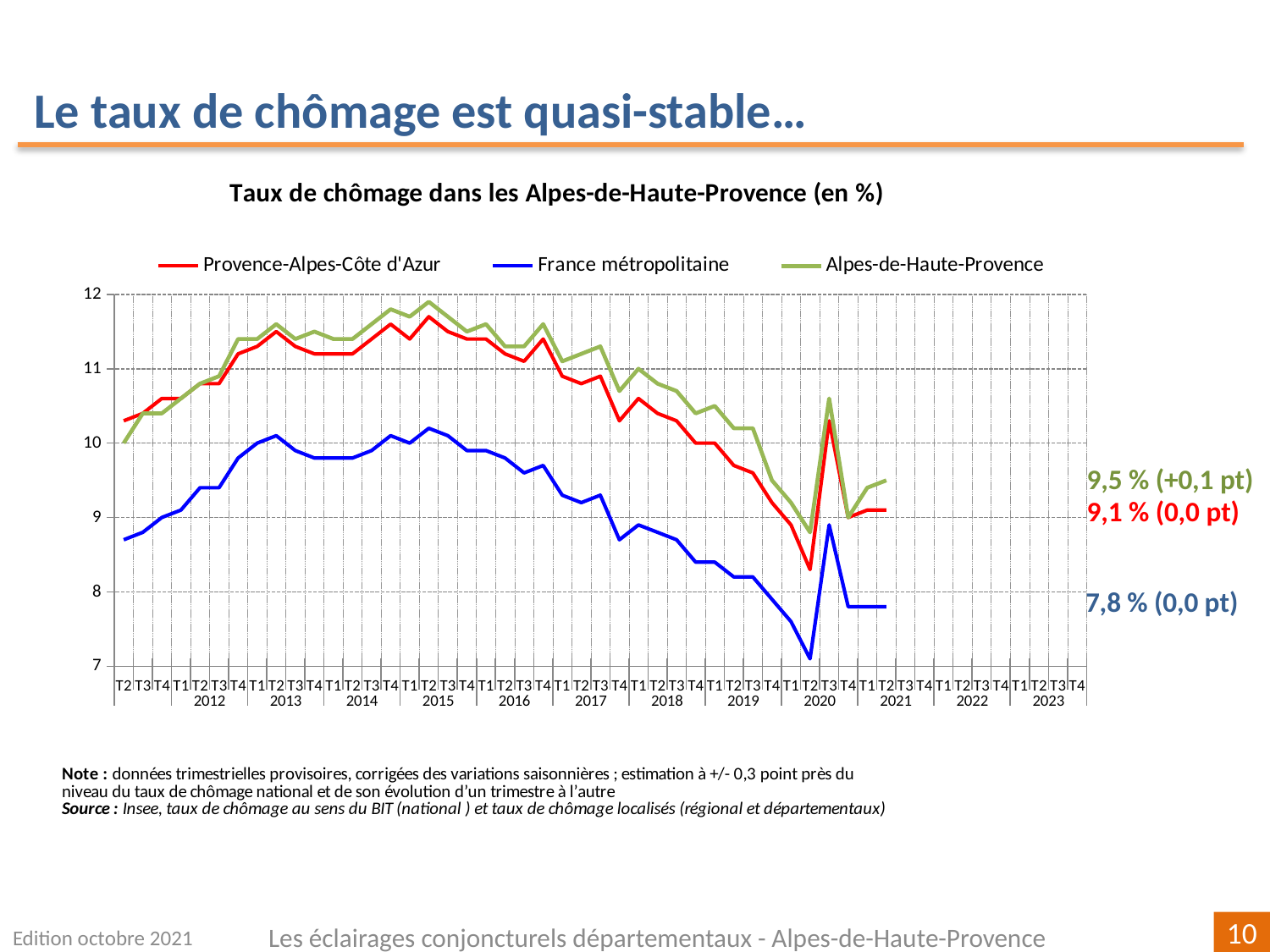
At the latest point, which is higher: Provence-Alpes-Côte d'Azur or France métropolitaine? Provence-Alpes-Côte d'Azur What is the latest unemployment rate shown for Alpes-de-Haute-Provence? 9,5 % What is the latest unemployment rate shown for France métropolitaine? 7,8 % By how many points did the Alpes-de-Haute-Provence rate change in the latest quarter, according to the label? +0,1 pt Between 2015 and 2019, does the France métropolitaine line rise or fall? fall Which series has the lowest values across the whole period? France métropolitaine What kind of chart is shown on the slide? line chart How many series does the legend list? 3 What is the difference between the latest rates for Alpes-de-Haute-Provence and France métropolitaine? 1,7 points Is the value for France métropolitaine in T2 2020 greater or less than 8? less What is the latest unemployment rate shown for Provence-Alpes-Côte d'Azur? 9,1 % Is the value for Alpes-de-Haute-Provence in T2 2015 greater or less than 11? greater